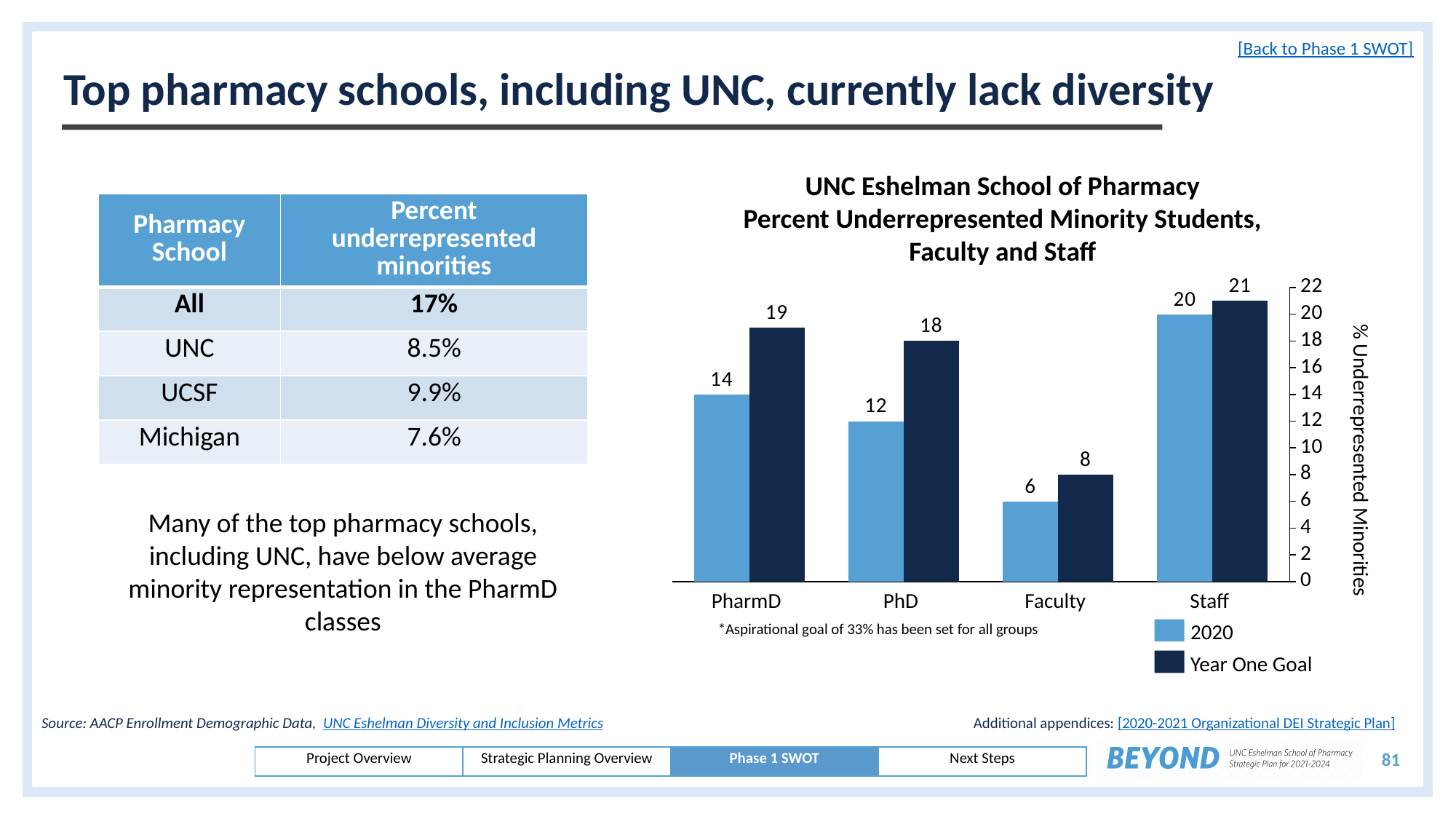
What is the difference between the Year One Goal and 2020 values for PhD? 6 What is the 2020 value for Faculty? 6 Which category has the lowest Year One Goal value? Faculty What kind of chart is shown on the slide? bar chart How many series does the chart legend list? 2 Which is larger, the 2020 value for PharmD or the 2020 value for PhD? PharmD Which category has the highest 2020 value? Staff How many categories are shown on the x axis of the chart? 4 What is the Year One Goal value for Staff? 21 What is the 2020 value for PharmD? 14 What is the label of the vertical axis of the chart? % Underrepresented Minorities What is the Year One Goal value for PhD? 18